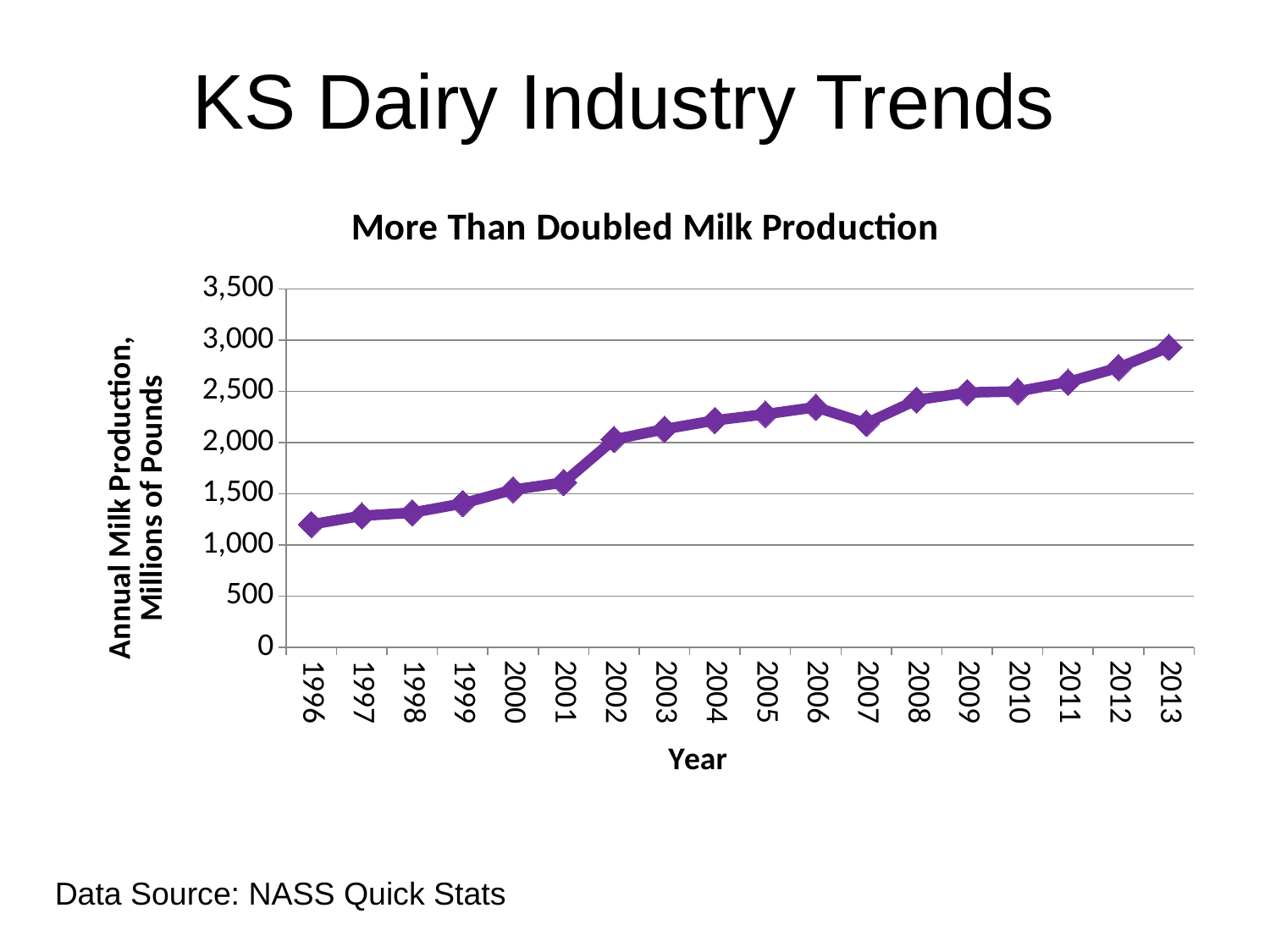
Is the value for 1996 greater or less than 1,500? less Is the value for 2007 greater or less than 2,500? less Which year has the lowest annual milk production in the chart? 1996 Which year has the larger milk production, 2006 or 2007? 2006 Which year has the highest annual milk production in the chart? 2013 How many years are plotted on the x axis of the chart? 18 Is the value for 2006 greater or less than 2,000? greater What kind of chart is shown on the slide? Line chart Overall, does annual milk production rise or fall from 1996 to 2013? Rise What is the title of the chart? More Than Doubled Milk Production What is the label of the y axis of the chart? Annual Milk Production, Millions of Pounds